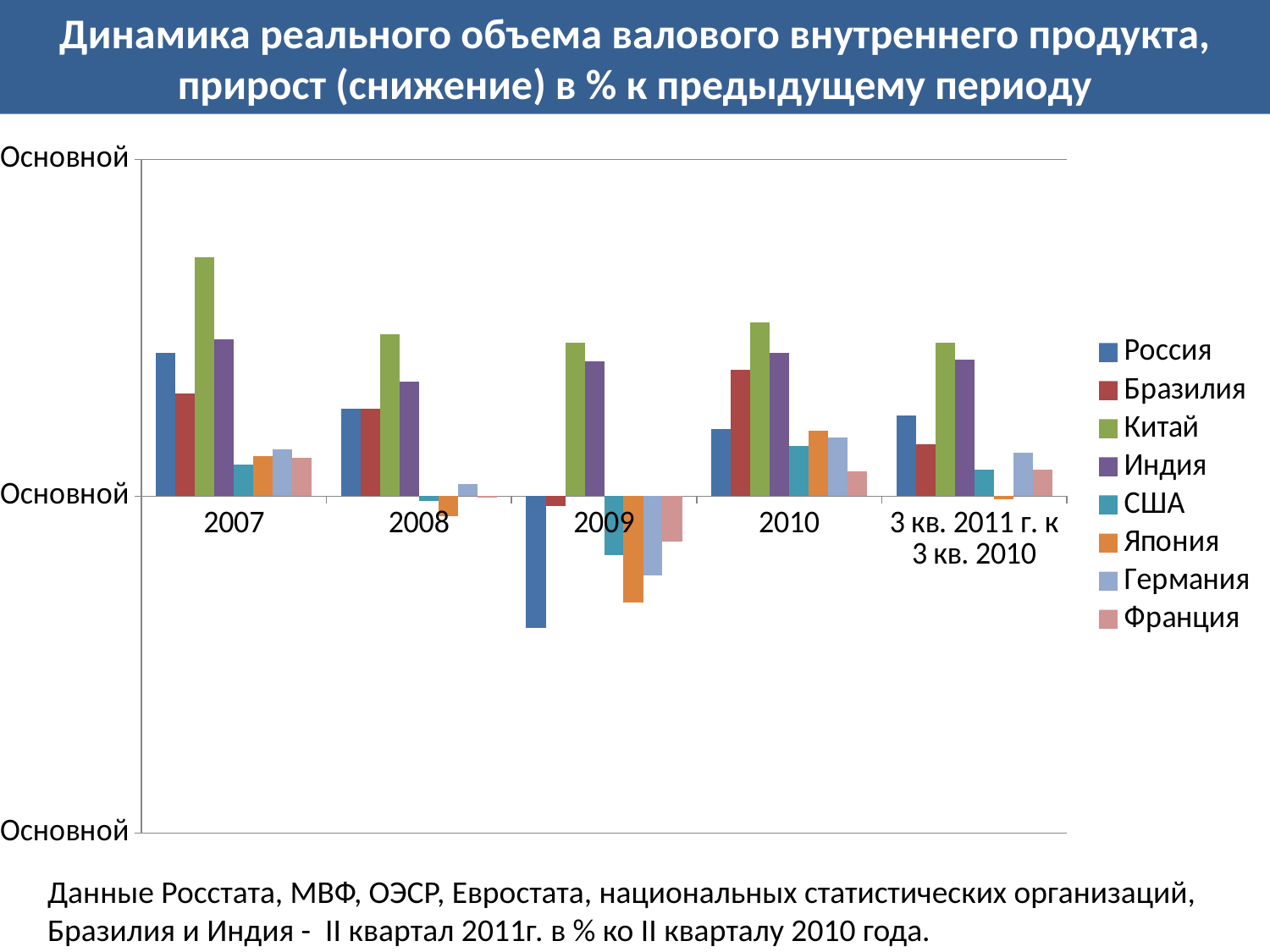
What kind of chart is shown on the slide? bar chart Which country has the lowest value in 2009? Россия How many period categories are shown along the x axis? 5 In 2007, which is larger: the value for Россия or the value for Бразилия? Россия Which country is listed first in the legend? Россия Does the value for Россия rise or fall from 2007 to 2009? fall Which country has the highest value in 2009? Китай Which country has the highest value in 2007? Китай In 2010, which is larger: the value for Россия or the value for Бразилия? Бразилия How many series does the legend list? 8 Which series is shown in green in the legend? Китай Which country has the highest value in 2010? Китай